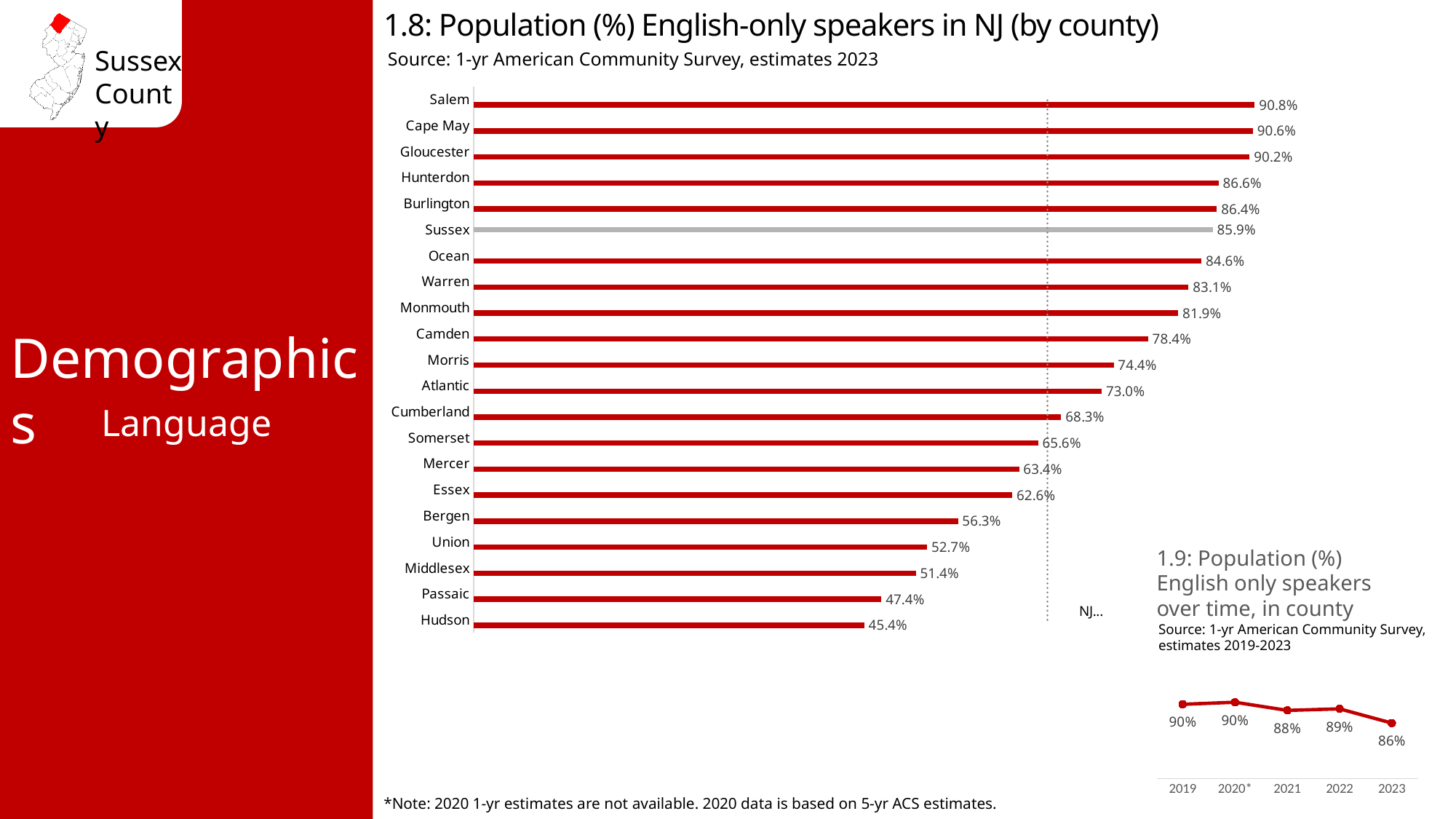
In chart 1.9, what is the value for 2023? 86% In chart 1.9, what is the difference between the values for 2019 and 2023? 4% In chart 1.8, which is larger, the value for Morris or the value for Camden? Camden In chart 1.8, which county's bar is coloured grey instead of red? Sussex In chart 1.9, how many years are plotted? 5 In chart 1.8, what is the value for Sussex? 85.9% In chart 1.8, which county has the highest percentage of English-only speakers? Salem What kind of chart is chart 1.8? Bar chart In chart 1.8, which county has the lowest percentage of English-only speakers? Hudson In chart 1.8, how many counties are shown? 21 In chart 1.8, what is the difference between the values for Salem and Hudson? 45.4% In chart 1.8, what is the value for Hudson? 45.4%